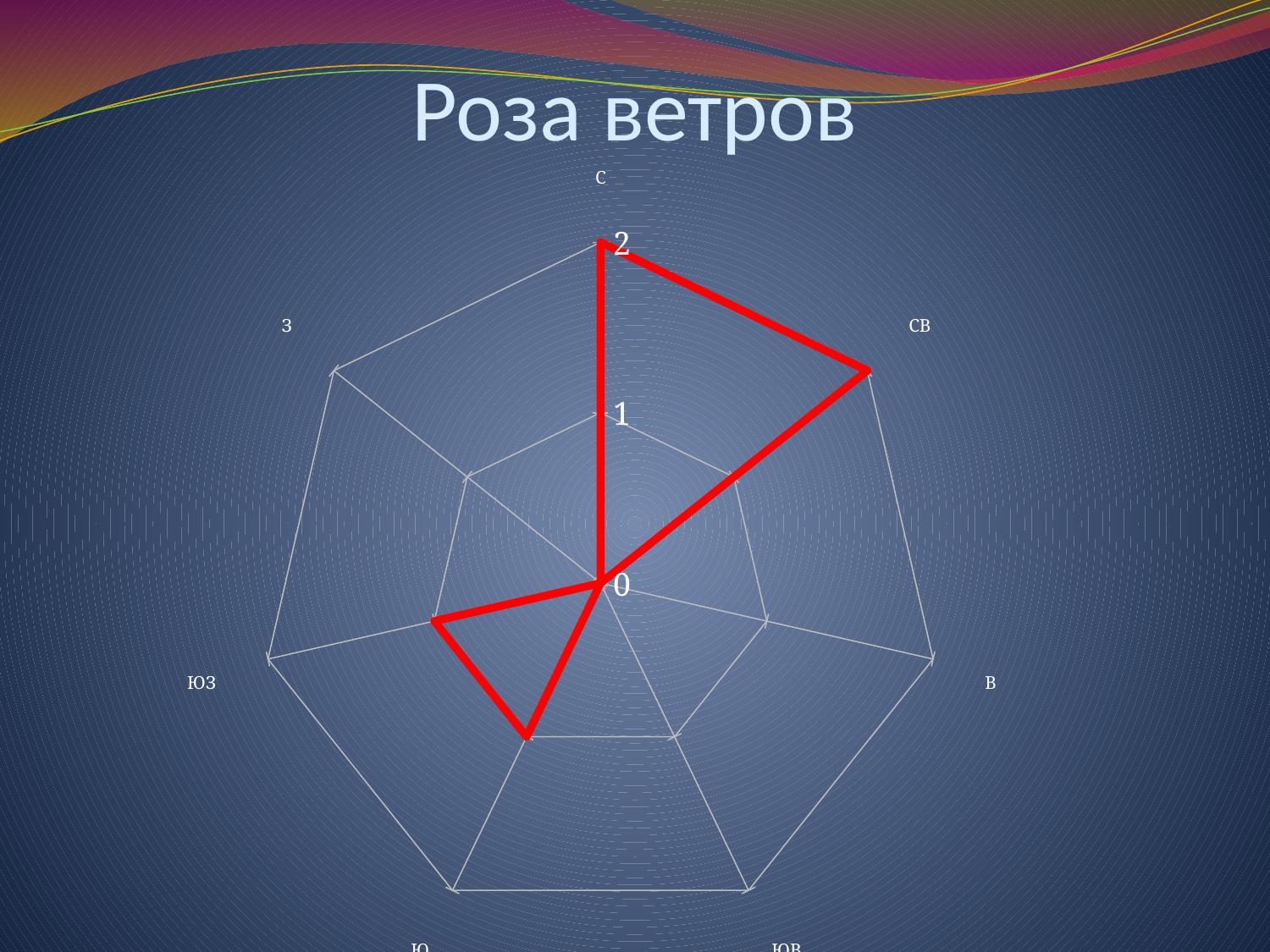
What is the difference between the value for С and the value for ЮЗ? 1 What kind of chart is shown on the slide? radar chart What colour is the data line on the chart? red What is the value for СВ? 2 What is the value for С? 2 Which is larger, the value for ЮЗ or the value for З? ЮЗ What is the value for В? 0 What is the value for З? 0 How many categories (directions) does the chart have? 7 What is the value for ЮЗ? 1 What is the title of the chart? Роза ветров Which is larger, the value for С or the value for ЮЗ? С